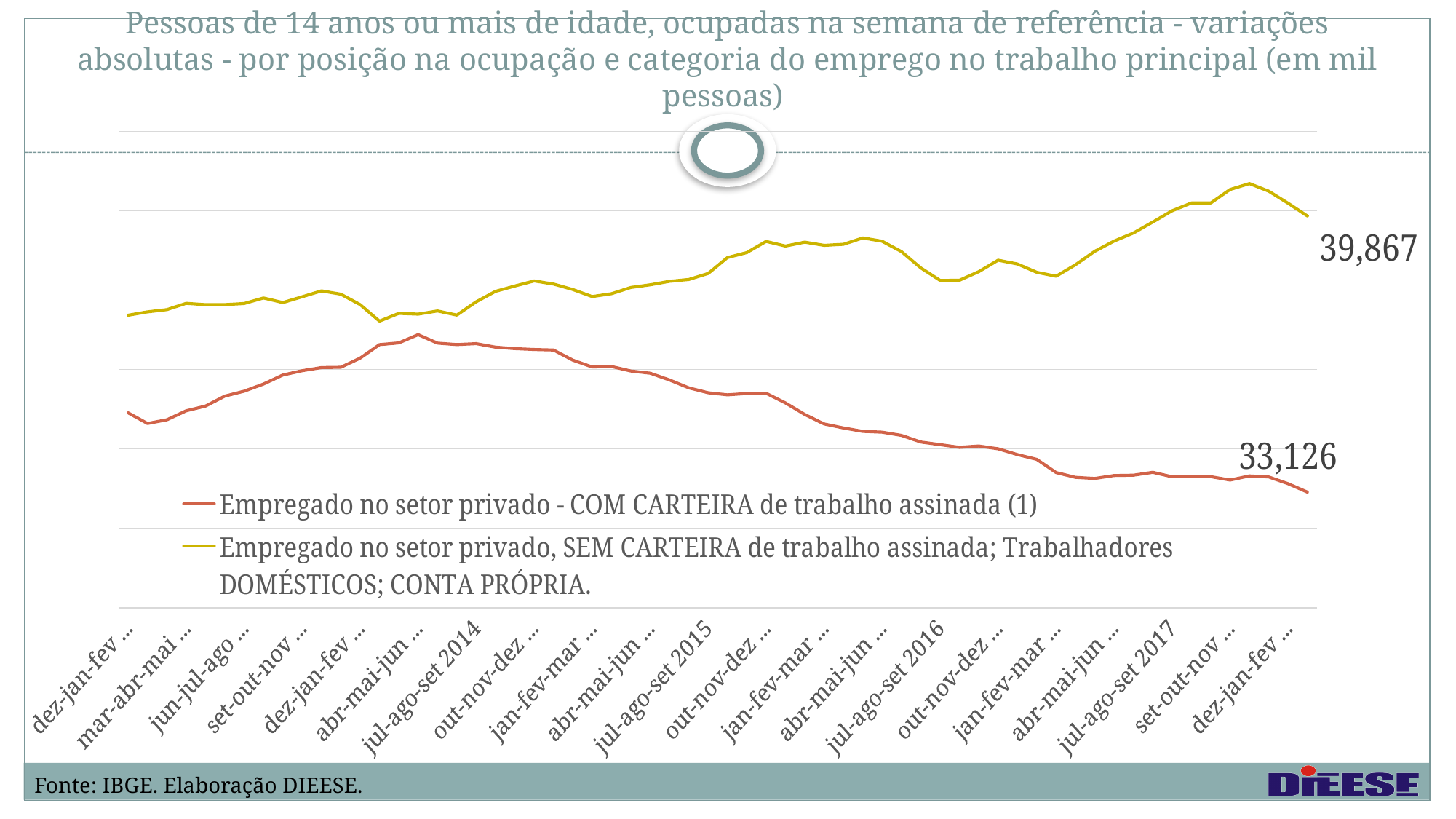
Does the 'SEM CARTEIRA' series rise or fall from jul-ago-set 2016 to set-out-nov 2017? rise How many series does the legend list? 2 Which colour is used for the 'Empregado no setor privado - COM CARTEIRA de trabalho assinada (1)' series? red Does the 'COM CARTEIRA' series rise or fall from jul-ago-set 2015 to the end of the period? fall What is the difference between the two labelled end values, 39,867 and 33,126? 6,741 At the end of the period, which series has the larger value: COM CARTEIRA or SEM CARTEIRA? SEM CARTEIRA What source is cited at the bottom of the slide? Fonte: IBGE. Elaboração DIEESE. Does the 'COM CARTEIRA' series rise or fall from the start of the period to jul-ago-set 2014? rise What is the last labelled value of the series 'Empregado no setor privado - COM CARTEIRA de trabalho assinada (1)'? 33,126 What is the last labelled value of the series 'Empregado no setor privado, SEM CARTEIRA de trabalho assinada; Trabalhadores DOMÉSTICOS; CONTA PRÓPRIA.'? 39,867 What kind of chart is shown on the slide? line chart